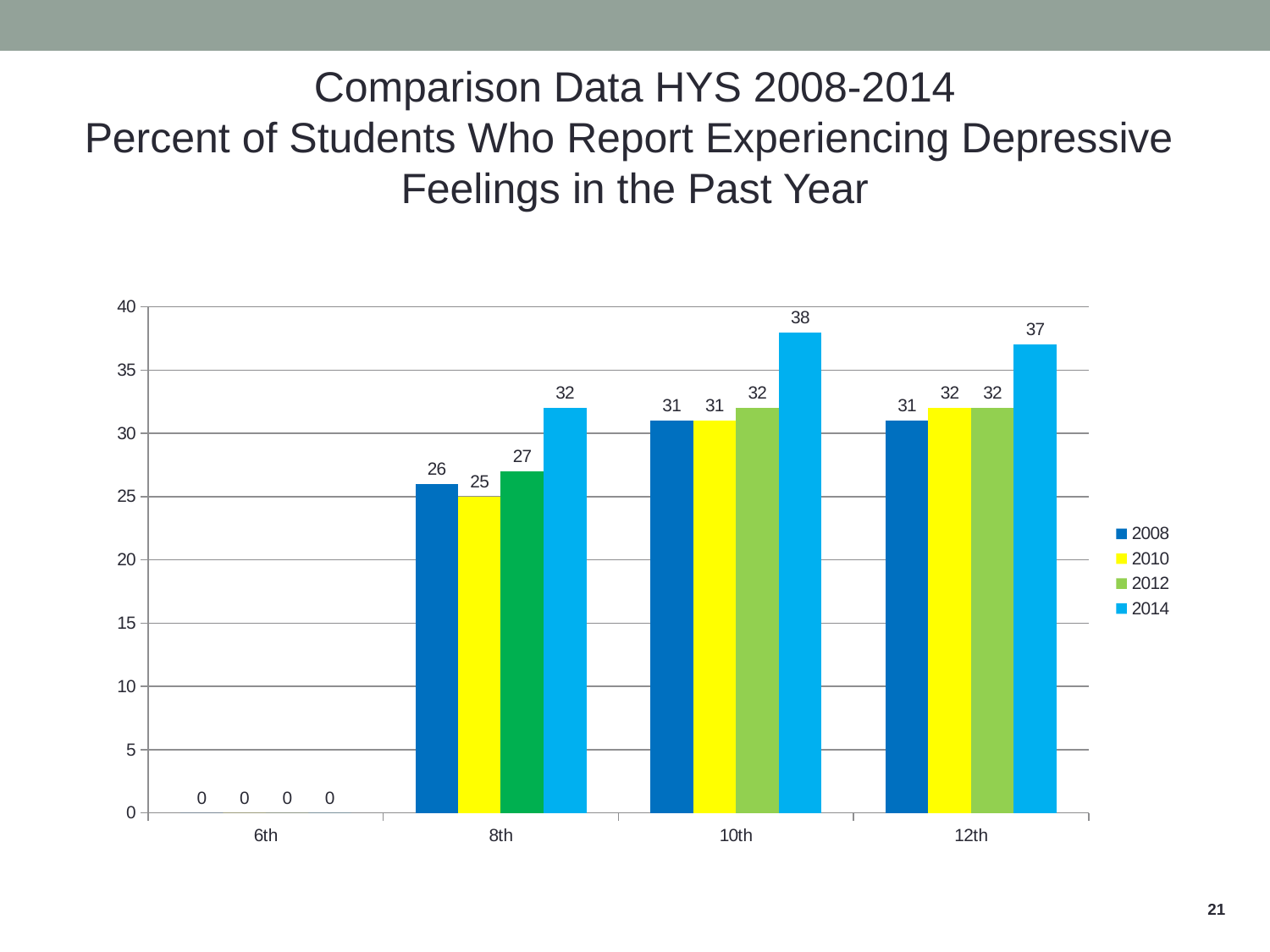
What is the value for 2008 in the 12th grade category? 31 How many series does the legend list? 4 What is the difference between the 2014 and 2008 values for 10th grade? 7 Which grade has the lowest value for the 2012 series? 6th What colour represents the 2010 series in the legend? Yellow Does the 2014 series rise or fall from 6th grade to 10th grade? Rise Which grade has the highest value for the 2014 series? 10th What kind of chart is shown on the slide? Bar chart Which is larger for 8th grade: the 2012 value or the 2010 value? 2012 What is the value for 2014 in the 10th grade category? 38 How many grade categories are shown on the x axis? 4 What is the value for 2010 in the 8th grade category? 25